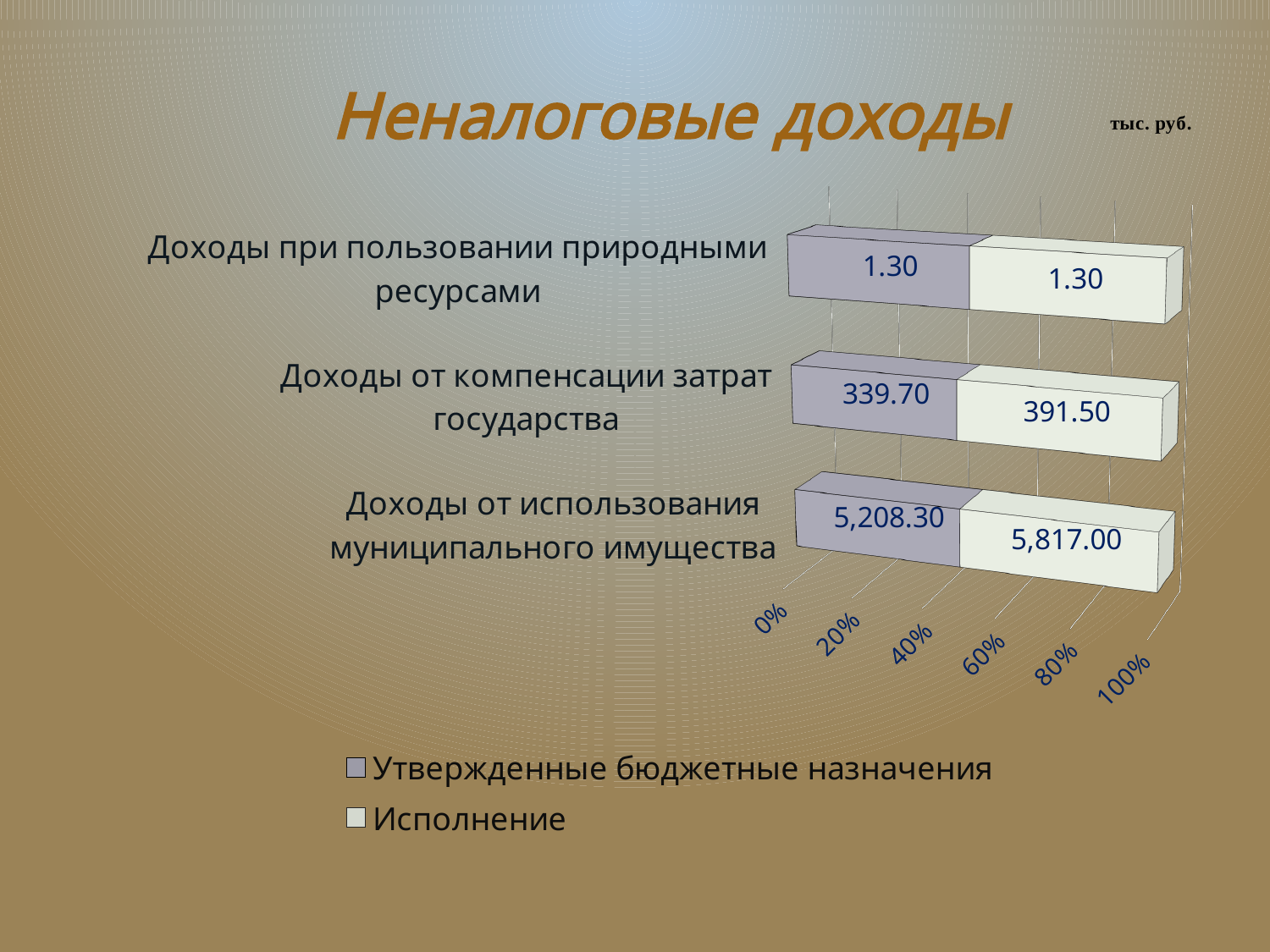
What is the sum of the two values shown on the bar for Доходы от компенсации затрат государства? 731.20 For Доходы от компенсации затрат государства, which is larger: Утвержденные бюджетные назначения or Исполнение? Исполнение What is the title of the chart? Неналоговые доходы What is the Исполнение value for Доходы от компенсации затрат государства? 391.50 How many categories are shown on the chart? 3 Which category has the highest Исполнение value? Доходы от использования муниципального имущества What is the difference between the Исполнение and Утвержденные бюджетные назначения values for Доходы от использования муниципального имущества? 608.70 Which category has the lowest Утвержденные бюджетные назначения value? Доходы при пользовании природными ресурсами What is the Исполнение value for Доходы при пользовании природными ресурсами? 1.30 What is the Утвержденные бюджетные назначения value for Доходы от использования муниципального имущества? 5,208.30 How many series does the legend list? 2 What kind of chart is shown on the slide? bar chart